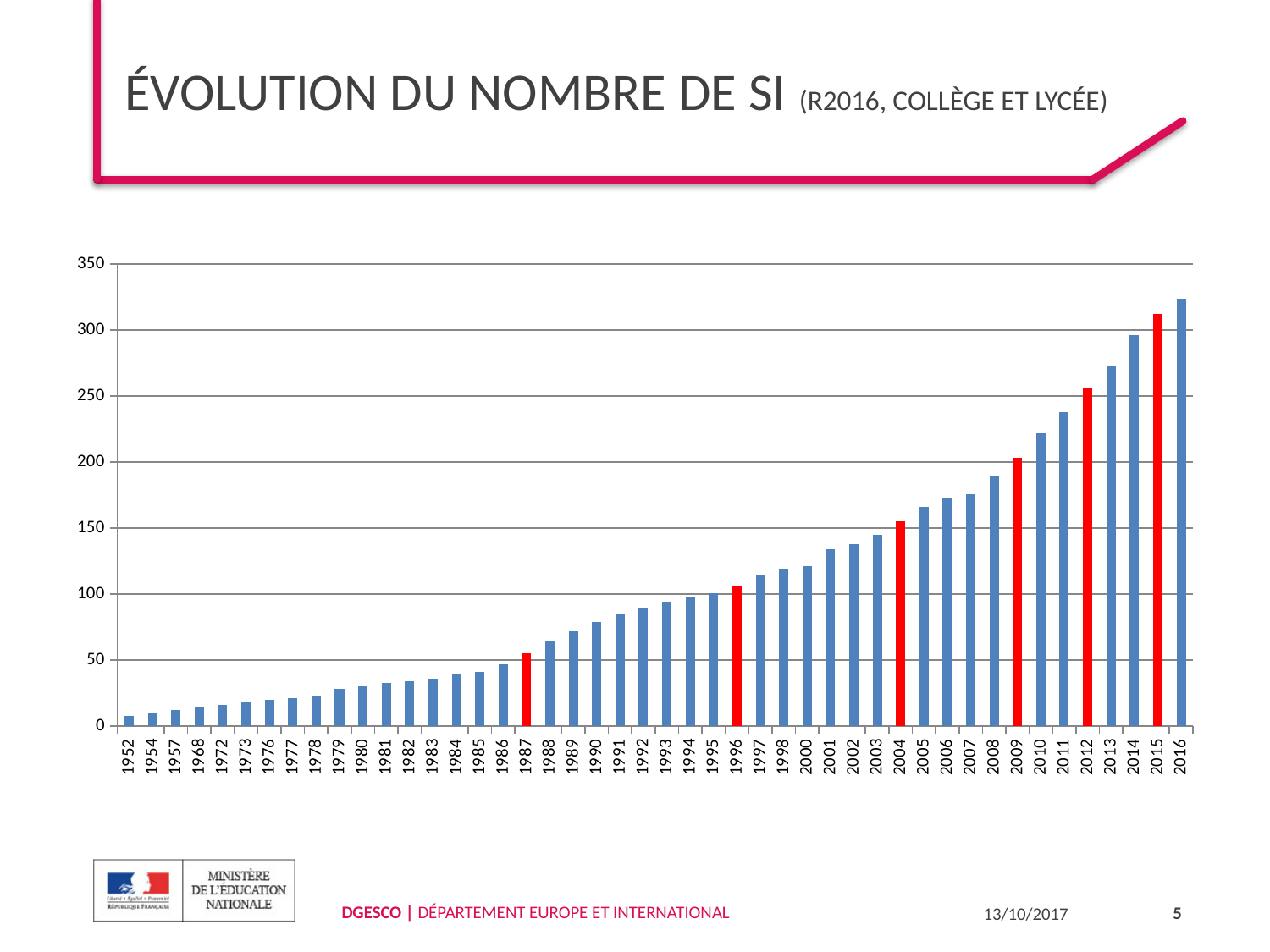
How many bars are coloured red in the chart? 6 Which year has the highest value in the chart? 2016 What kind of chart is shown on the slide? bar chart Is the value for 2008 greater or less than 200? less Is the value for 2013 greater or less than 250? greater How many years (bars) are shown on the x axis? 46 Which year has the lowest value in the chart? 1952 Is the value for 2016 greater or less than 300? greater Do the values generally rise or fall from 1952 to 2016? rise Which is larger, the value for 2012 or the value for 2009? 2012